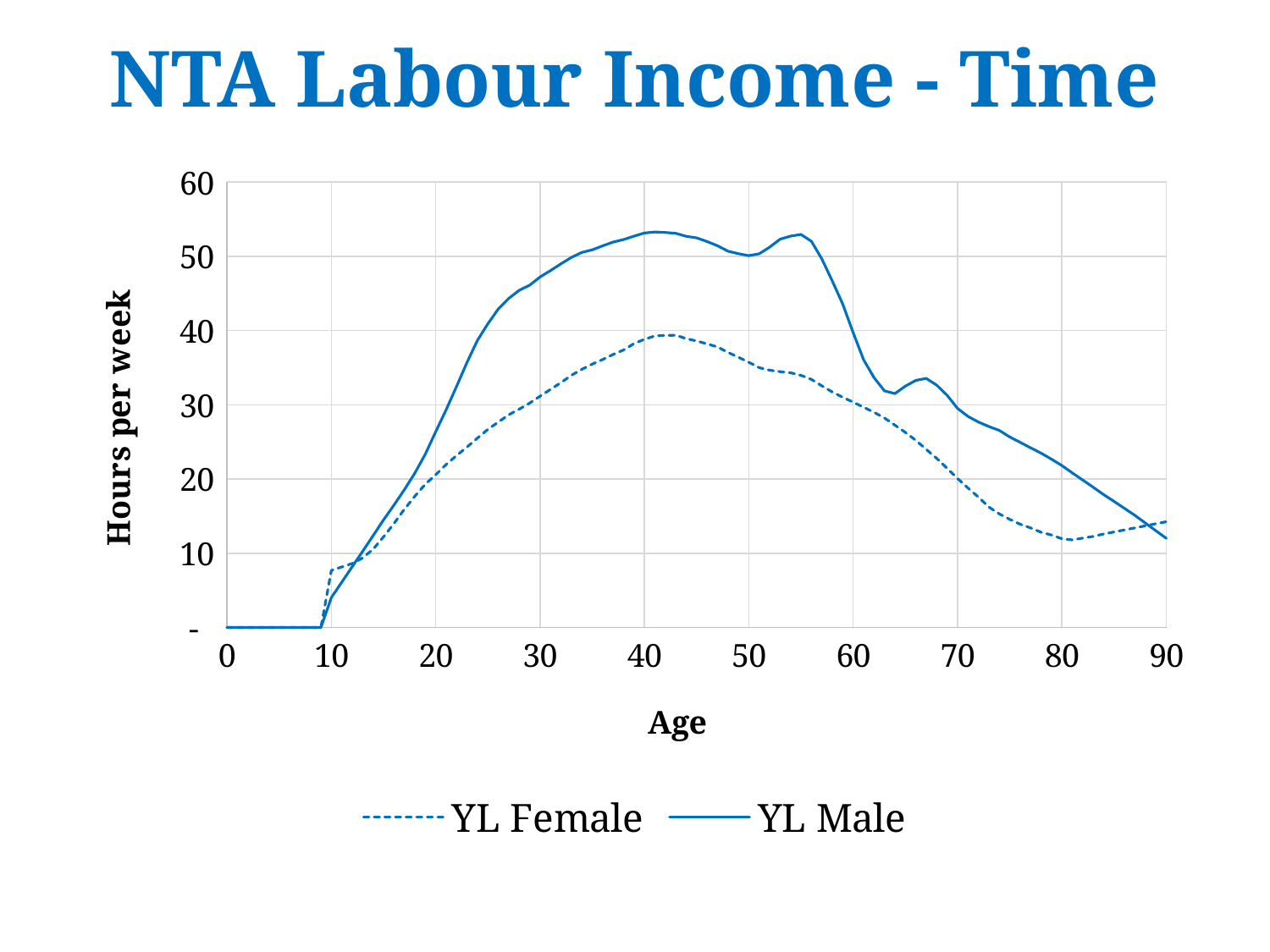
Is the value for YL Female at age 50 greater or less than 30? greater Is the value for YL Male at age 70 greater or less than 40? less What is the title of the chart? NTA Labour Income - Time At age 40, which series has the higher value, YL Female or YL Male? YL Male Is the value for YL Male at age 40 greater or less than 50? greater What is the label of the vertical axis? Hours per week Does the YL Male line rise or fall between age 60 and age 80? fall How many series does the legend list? 2 What kind of chart is shown on the slide? line chart Which series reaches the higher peak value? YL Male